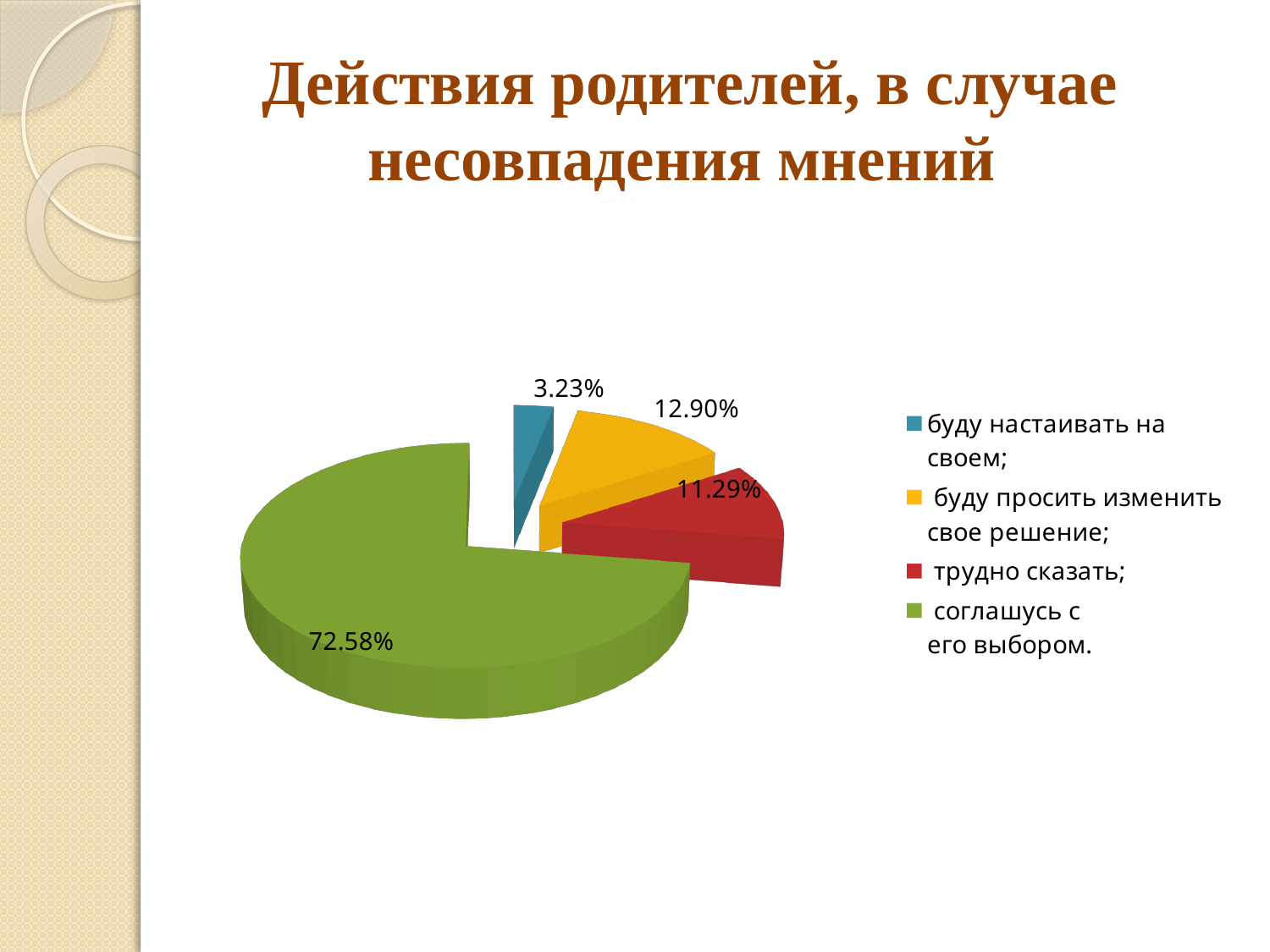
What share of the pie is labelled "трудно сказать"? 11.29% What share of the pie is labelled "буду настаивать на своем"? 3.23% How many slices does the pie chart have? 4 What share of the pie is labelled "буду просить изменить свое решение"? 12.90% What colour is the slice for "трудно сказать"? red Which category has the smallest slice of the pie? буду настаивать на своем What share of the pie is labelled "соглашусь с его выбором"? 72.58% What is the difference between the shares for "соглашусь с его выбором" and "буду настаивать на своем"? 69.35% What kind of chart is shown on the slide? pie chart Which category has the largest slice of the pie? соглашусь с его выбором Which is larger: the slice for "буду просить изменить свое решение" or the slice for "трудно сказать"? буду просить изменить свое решение What is the difference between the shares for "буду просить изменить свое решение" and "трудно сказать"? 1.61%